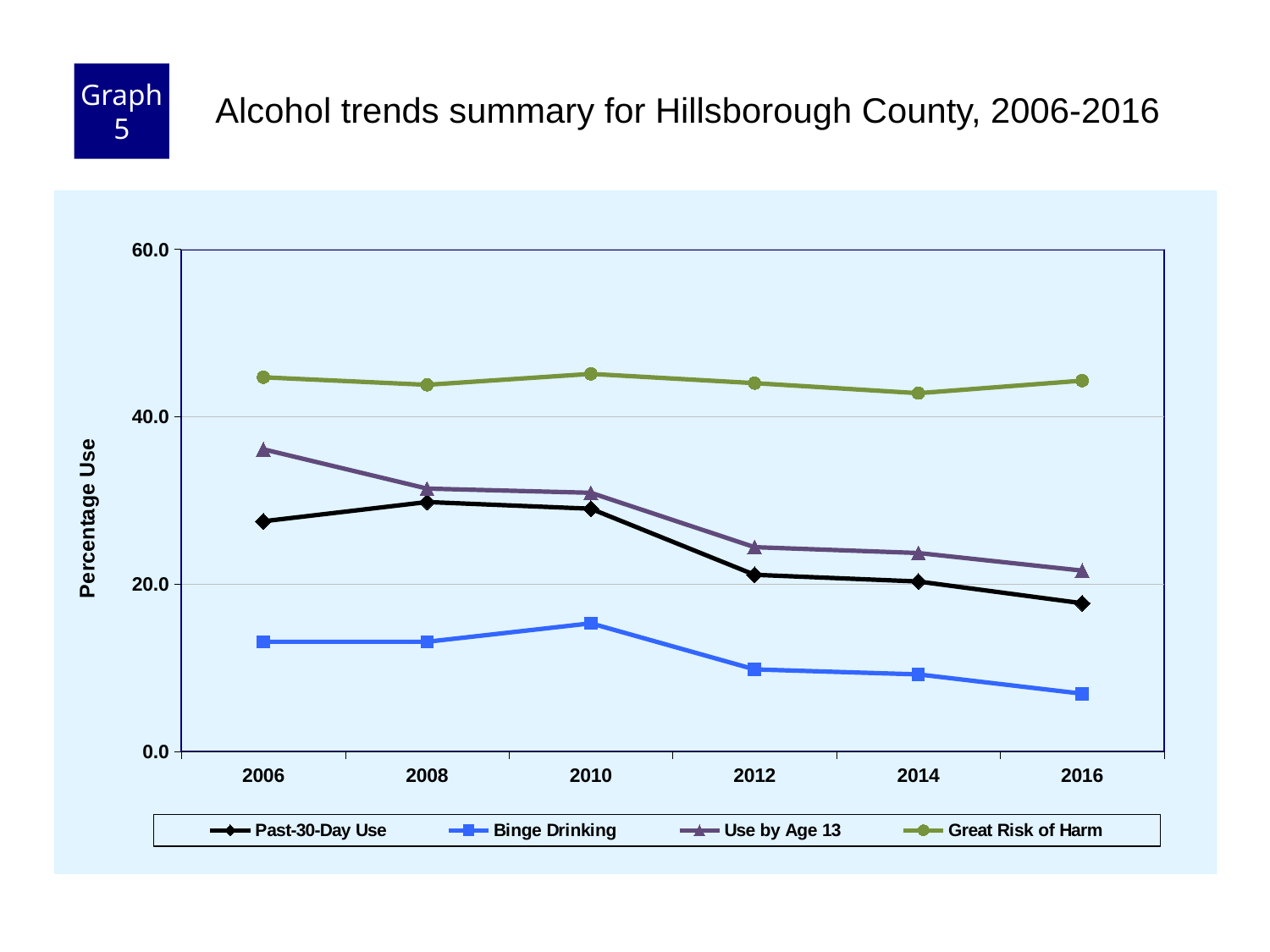
What is the label on the y axis? Percentage Use In 2006, which is larger: Use by Age 13 or Past-30-Day Use? Use by Age 13 In which year is Past-30-Day Use at its lowest? 2016 Does Binge Drinking rise or fall from 2010 to 2016? Fall What is the title of the chart? Alcohol trends summary for Hillsborough County, 2006-2016 Is the value for Binge Drinking in 2016 greater or less than 20.0? less Is the value for Great Risk of Harm in 2010 greater or less than 40.0? greater How many years are plotted along the x axis? 6 How many series does the legend list? 4 What kind of chart is shown on the slide? Line chart In which year is Binge Drinking at its highest? 2010 Is the value for Past-30-Day Use in 2006 greater or less than 20.0? greater